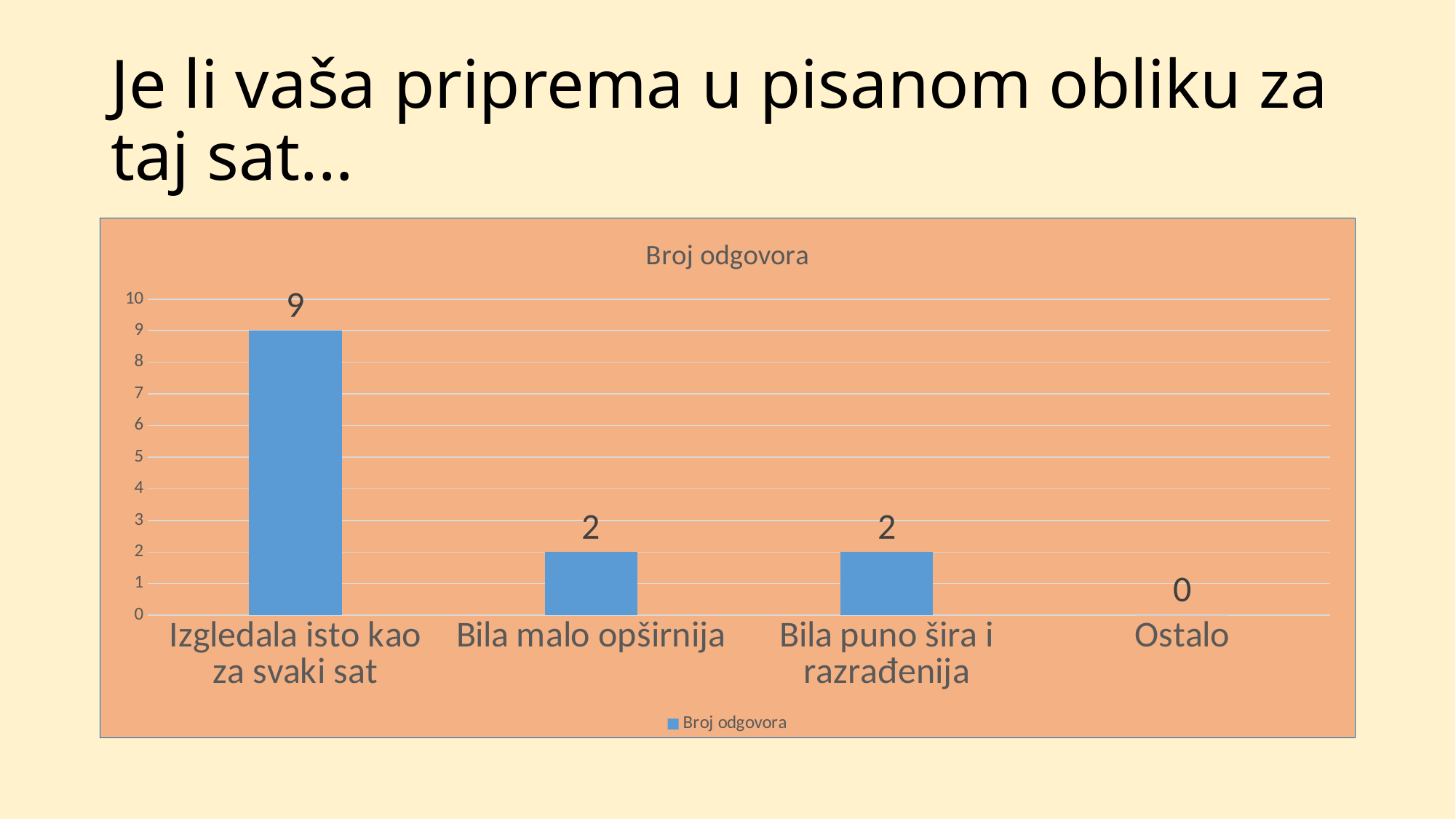
What is the value for "Bila malo opširnija"? 2 What is the value for "Izgledala isto kao za svaki sat"? 9 How many categories are shown on the x axis? 4 Which category has the highest value? Izgledala isto kao za svaki sat What is the value for "Ostalo"? 0 What is the title of the chart? Broj odgovora What kind of chart is shown on the slide? bar chart Which is larger: the value for "Bila malo opširnija" or the value for "Ostalo"? Bila malo opširnija How many series does the legend list? 1 Is the value for "Izgledala isto kao za svaki sat" greater or less than 5? greater Which category has the lowest value? Ostalo What is the difference between the values for "Izgledala isto kao za svaki sat" and "Bila puno šira i razrađenija"? 7